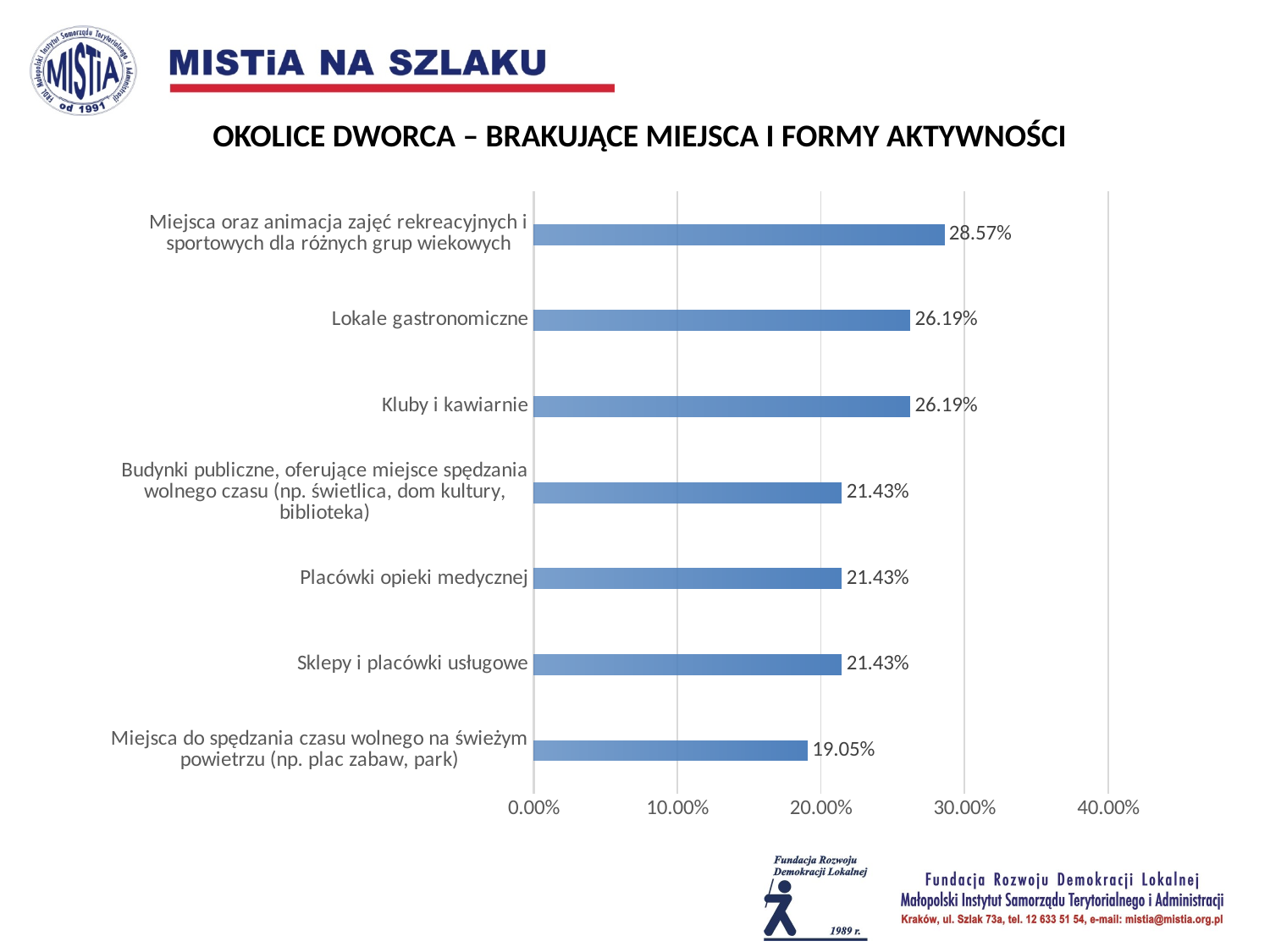
Which category has the highest value? Miejsca oraz animacja zajęć rekreacyjnych i sportowych dla różnych grup wiekowych What is the value for "Lokale gastronomiczne"? 26.19% What is the difference between the value for "Sklepy i placówki usługowe" and the value for "Miejsca do spędzania czasu wolnego na świeżym powietrzu (np. plac zabaw, park)"? 2.38% What is the difference between the value for "Miejsca oraz animacja zajęć rekreacyjnych i sportowych dla różnych grup wiekowych" and the value for "Lokale gastronomiczne"? 2.38% How many categories are shown in the chart? 7 Which category has the lowest value? Miejsca do spędzania czasu wolnego na świeżym powietrzu (np. plac zabaw, park) Is the value for "Miejsca oraz animacja zajęć rekreacyjnych i sportowych dla różnych grup wiekowych" greater or less than 30.00%? less What kind of chart is shown on the slide? bar chart What is the value for "Placówki opieki medycznej"? 21.43% What is the title of the chart? OKOLICE DWORCA – BRAKUJĄCE MIEJSCA I FORMY AKTYWNOŚCI What is the value for "Miejsca do spędzania czasu wolnego na świeżym powietrzu (np. plac zabaw, park)"? 19.05% Which is larger: the value for "Kluby i kawiarnie" or the value for "Placówki opieki medycznej"? Kluby i kawiarnie